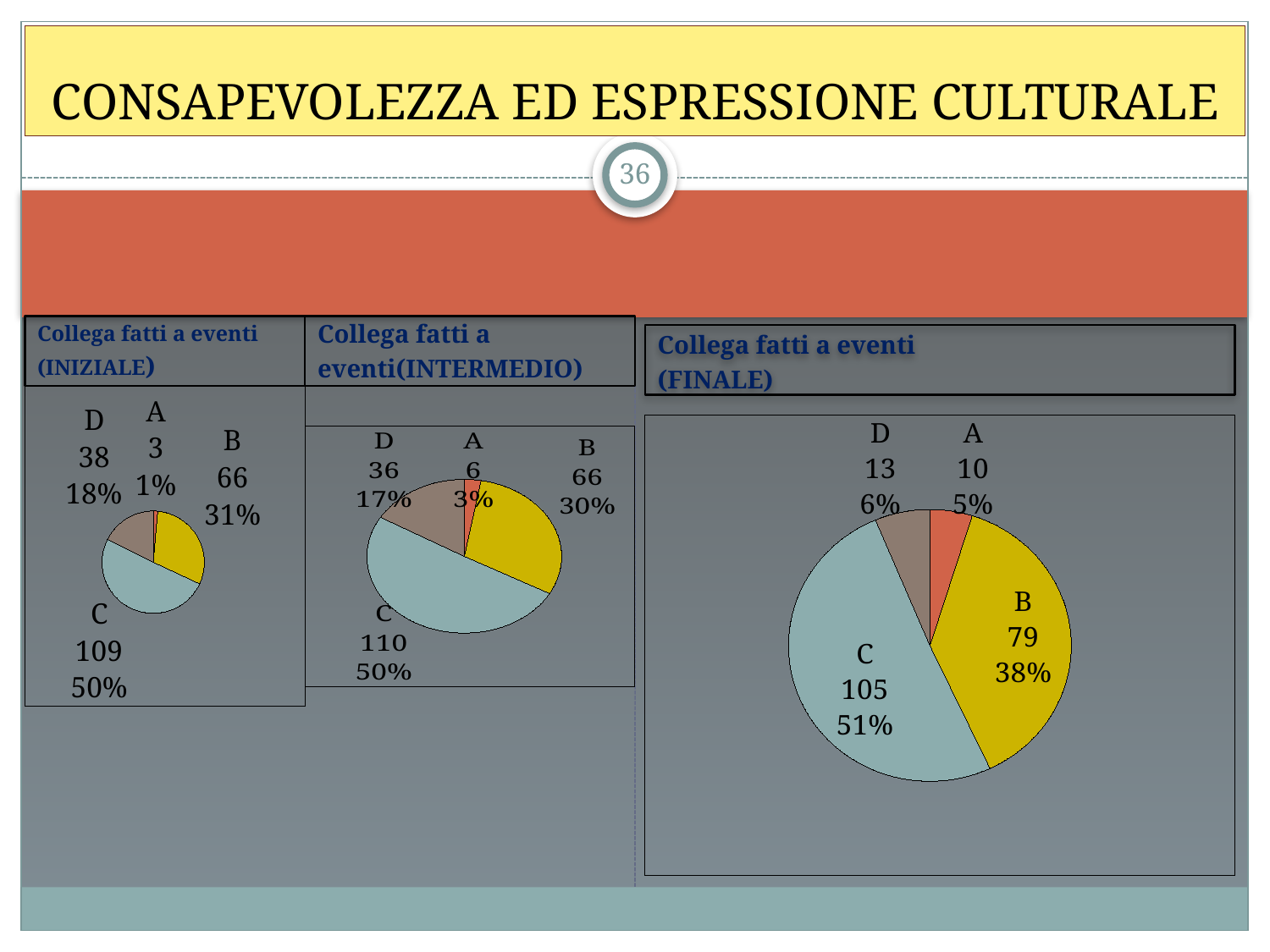
What kind of chart is used in the 'Collega fatti a eventi (INIZIALE)' panel? Pie chart In the 'Collega fatti a eventi(INTERMEDIO)' chart, what percentage share does category A have? 3% In the 'Collega fatti a eventi (INIZIALE)' chart, what percentage share does category B have? 31% In the 'Collega fatti a eventi(INTERMEDIO)' chart, which category has the largest value? C In the 'Collega fatti a eventi (FINALE)' chart, what is the difference between the values for C and B? 26 In the 'Collega fatti a eventi(INTERMEDIO)' chart, what is the value for category D? 36 In the 'Collega fatti a eventi (INIZIALE)' chart, what is the value for category C? 109 How many categories does the 'Collega fatti a eventi (FINALE)' chart show? 4 In the 'Collega fatti a eventi (FINALE)' chart, what is the value for category B? 79 In the 'Collega fatti a eventi (FINALE)' chart, what percentage share does category C have? 51% In the 'Collega fatti a eventi (FINALE)' chart, which is larger, the value for D or the value for A? D In the 'Collega fatti a eventi (INIZIALE)' chart, which category has the smallest value? A